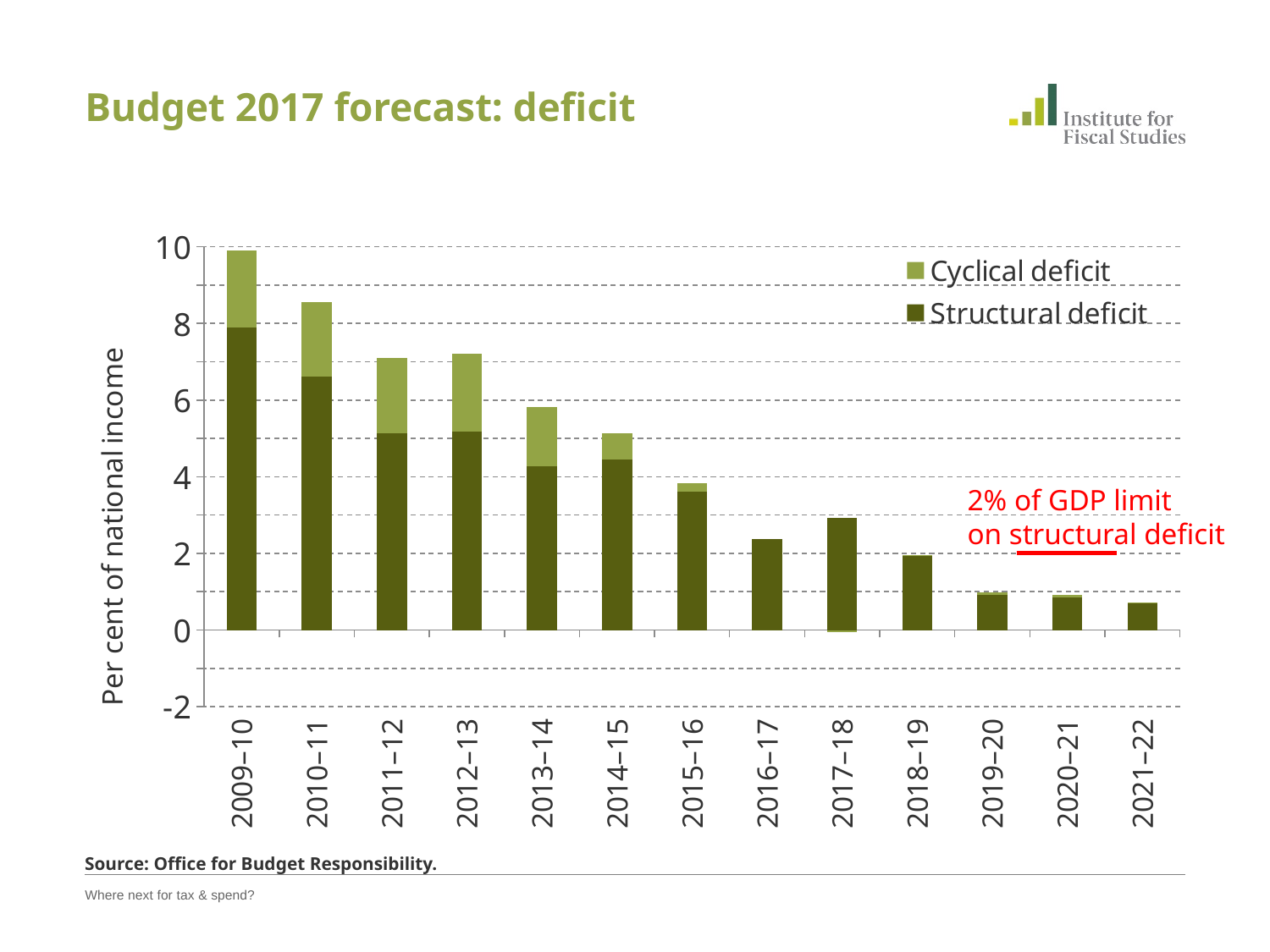
Is the structural deficit for 2017–18 greater or less than 2? greater Is the structural deficit for 2009–10 greater or less than 6? greater Which year has the highest total deficit? 2009–10 What is the source given for the chart? Office for Budget Responsibility Which is larger, the structural deficit in 2009–10 or in 2010–11? 2009–10 What kind of chart is shown on the slide? Stacked bar chart What is the label on the y axis? Per cent of national income Does the total deficit generally rise or fall from 2009–10 to 2021–22? Fall Is the total deficit for 2013–14 greater or less than 4? greater How many series does the legend list? 2 How many fiscal years are shown on the x axis? 13